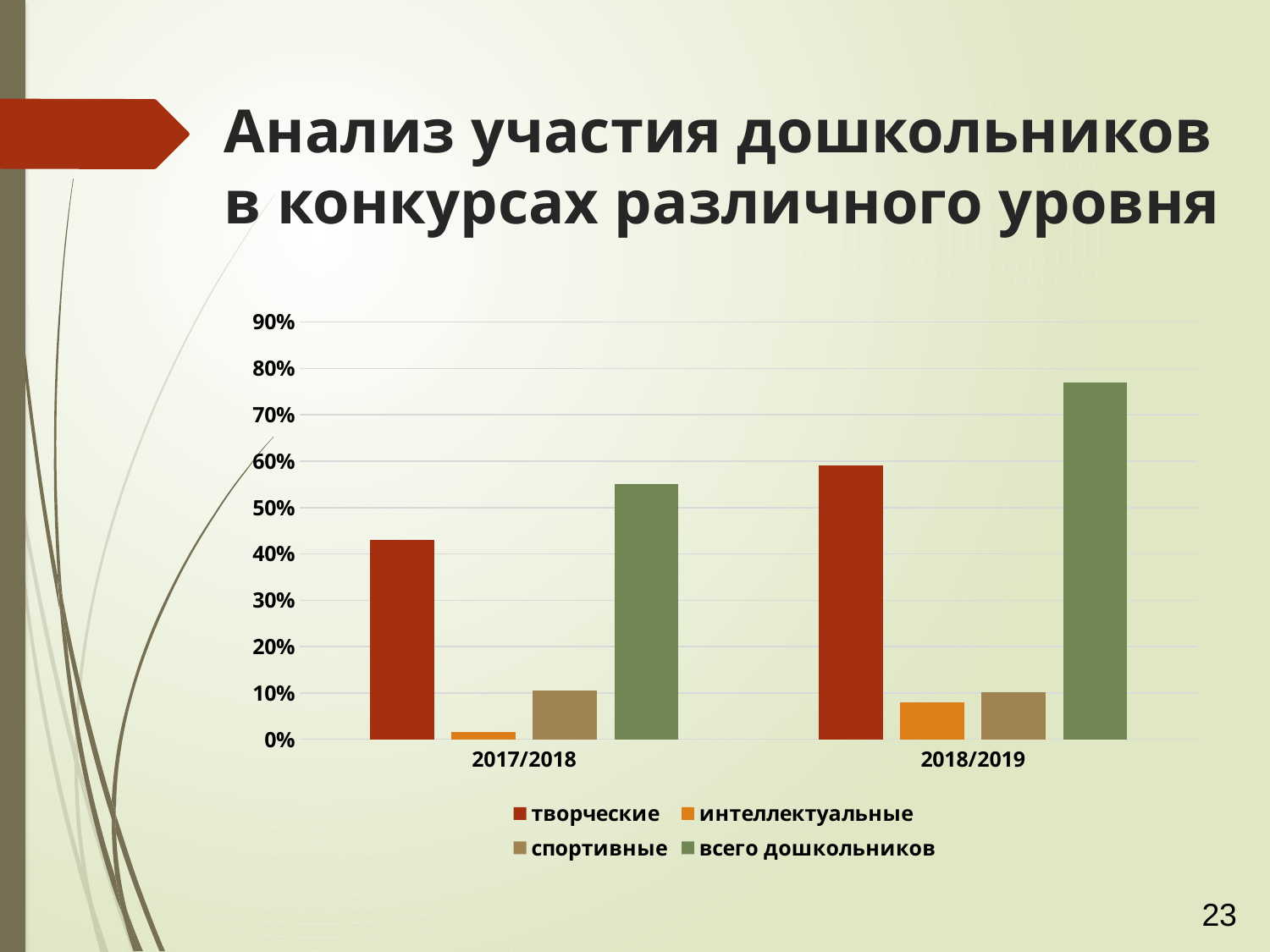
Is the value for творческие in 2017/2018 greater or less than 50%? less What colour are the bars for the series всего дошкольников? green Is the value for интеллектуальные in 2018/2019 greater or less than 10%? less Which series has the highest value in 2018/2019? всего дошкольников What kind of chart is shown on the slide? bar chart How many series does the legend list? 4 Is the value for всего дошкольников in 2018/2019 greater or less than 70%? greater Which is larger: творческие in 2017/2018 or творческие in 2018/2019? творческие in 2018/2019 How many categories are shown on the x axis? 2 Does the value for всего дошкольников rise or fall from 2017/2018 to 2018/2019? rise Which series has the lowest value in 2017/2018? интеллектуальные